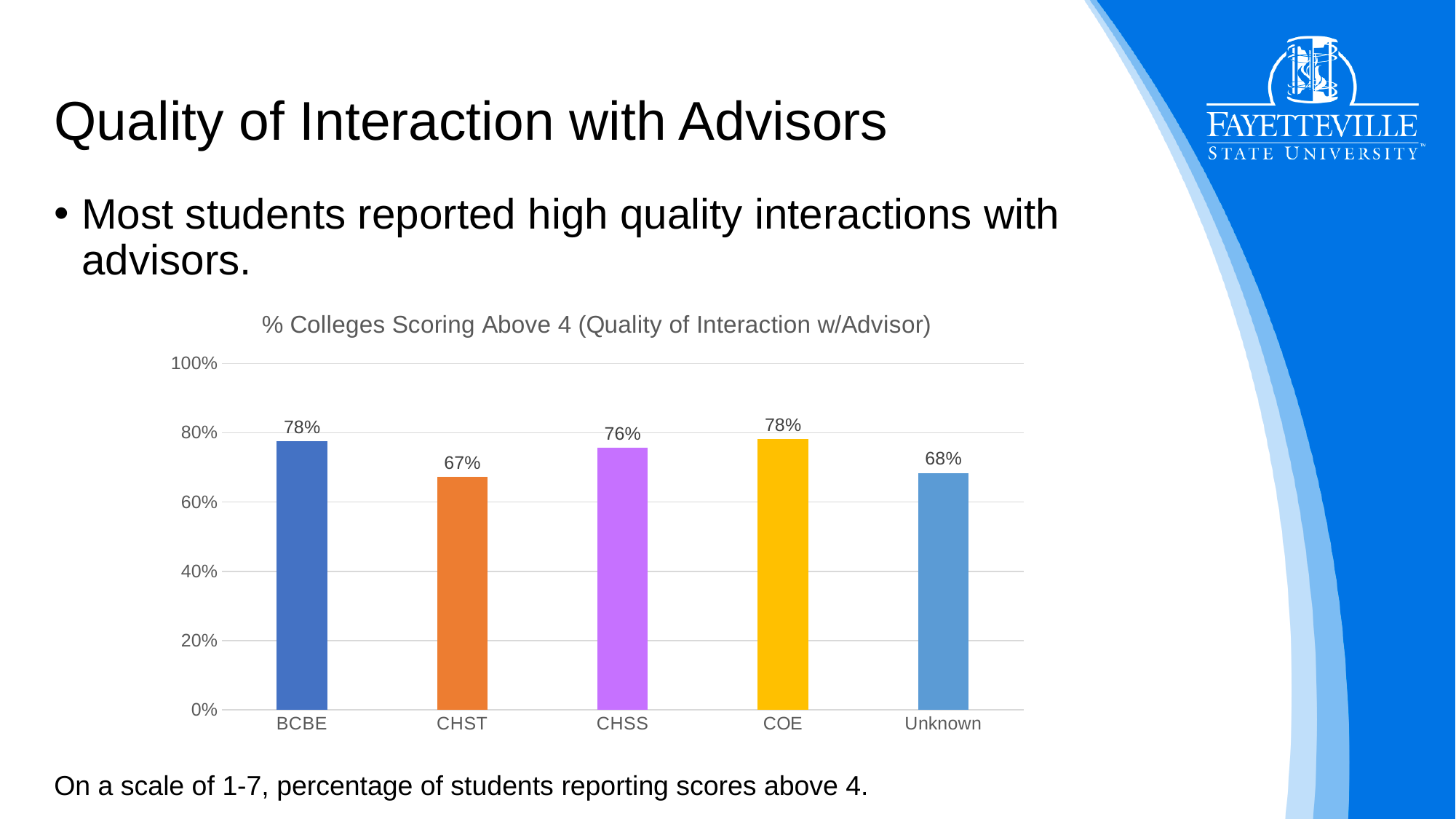
Is the value for CHST greater or less than 80%? less What is the value for Unknown? 68% What is the difference between the values for BCBE and CHST? 11 percentage points What is the value for CHSS? 76% What is the title of the chart? % Colleges Scoring Above 4 (Quality of Interaction w/Advisor) What is the difference between the values for CHSS and Unknown? 8 percentage points Which is larger, the value for COE or the value for Unknown? COE What is the value for COE? 78% What is the value for BCBE? 78% What is the value for CHST? 67% How many categories are shown on the x axis? 5 What kind of chart is shown on the slide? bar chart